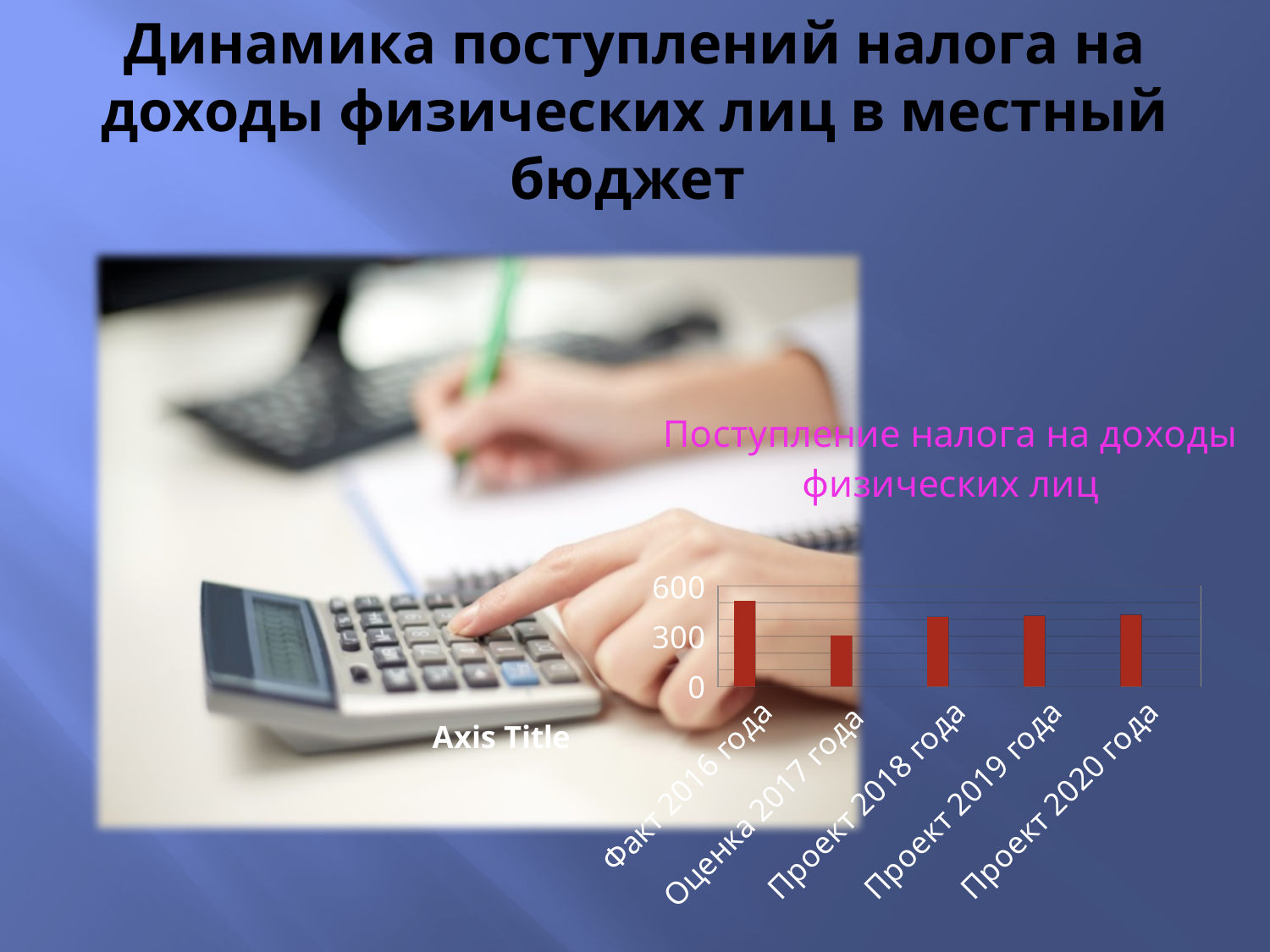
What kind of chart is shown on the slide? bar chart Is the value for Проект 2020 года greater or less than 600? less What is the title of the chart? Поступление налога на доходы физических лиц Is the value for Факт 2016 года greater or less than 300? greater What colour are the bars in the chart? red Which category has the highest value in the chart? Факт 2016 года Which category has the lowest value in the chart? Оценка 2017 года Is the value for Проект 2018 года greater or less than 300? greater How many categories are plotted in the chart? 5 Which is larger, the value for Факт 2016 года or the value for Оценка 2017 года? Факт 2016 года Which is larger, the value for Оценка 2017 года or the value for Проект 2018 года? Проект 2018 года